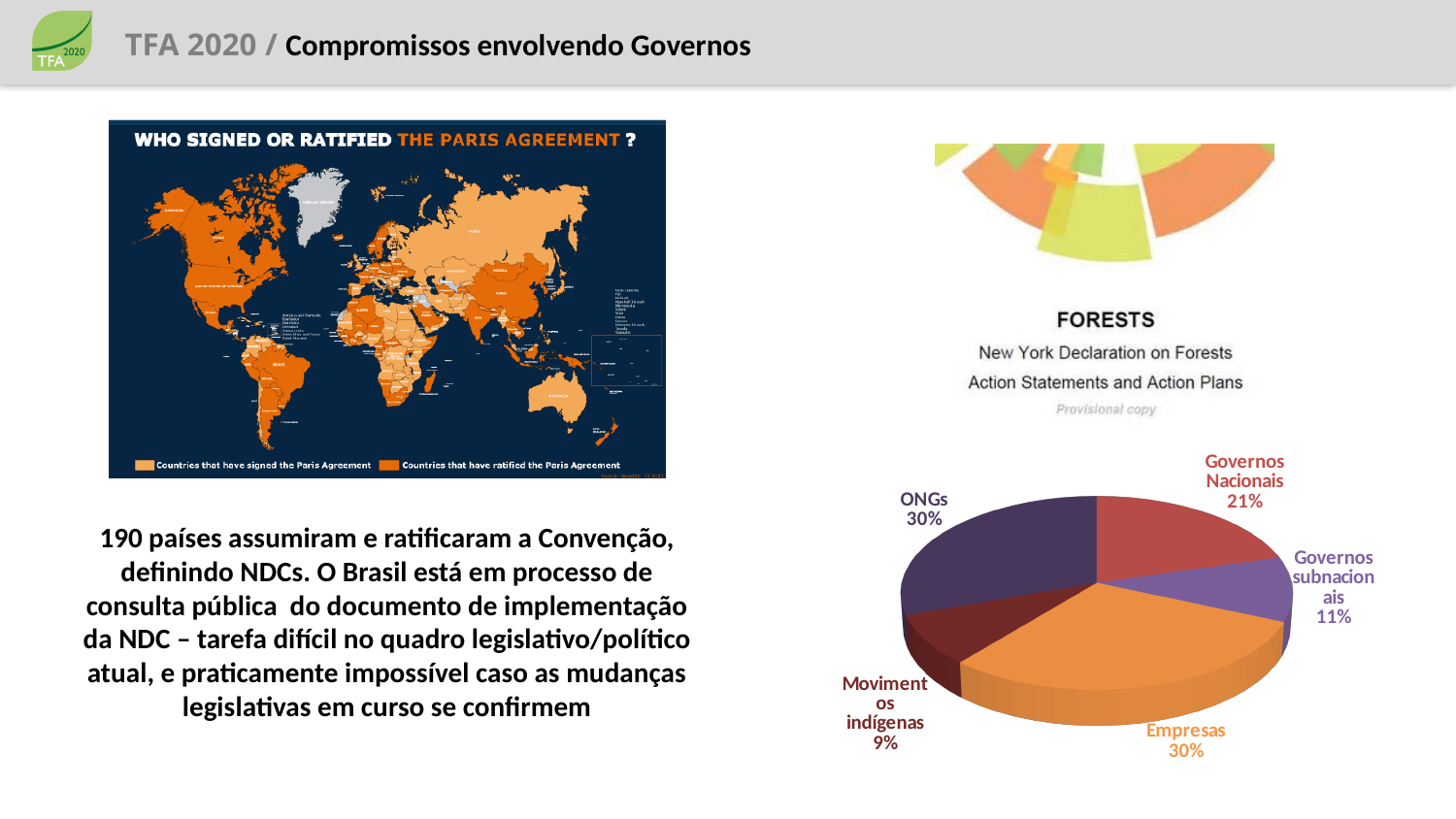
In the pie chart, what percentage is shown for Governos Nacionais? 21% In the pie chart, what share is labelled for ONGs? 30% In the pie chart, which category has the smallest share? Movimentos indígenas In the pie chart, what is the difference in percentage points between Empresas and Governos Nacionais? 9 In the pie chart, what percentage is shown for Empresas? 30% In the pie chart, what percentage is shown for Governos subnacionais? 11% How many slices does the pie chart have? 5 In the pie chart, what is the combined share of Governos Nacionais and Governos subnacionais? 32% In the pie chart, which is larger: Governos Nacionais or Governos subnacionais? Governos Nacionais What kind of chart is shown in the lower right of the slide? pie chart In the pie chart, what percentage is shown for Movimentos indígenas? 9% In the pie chart, what is the difference in percentage points between ONGs and Movimentos indígenas? 21